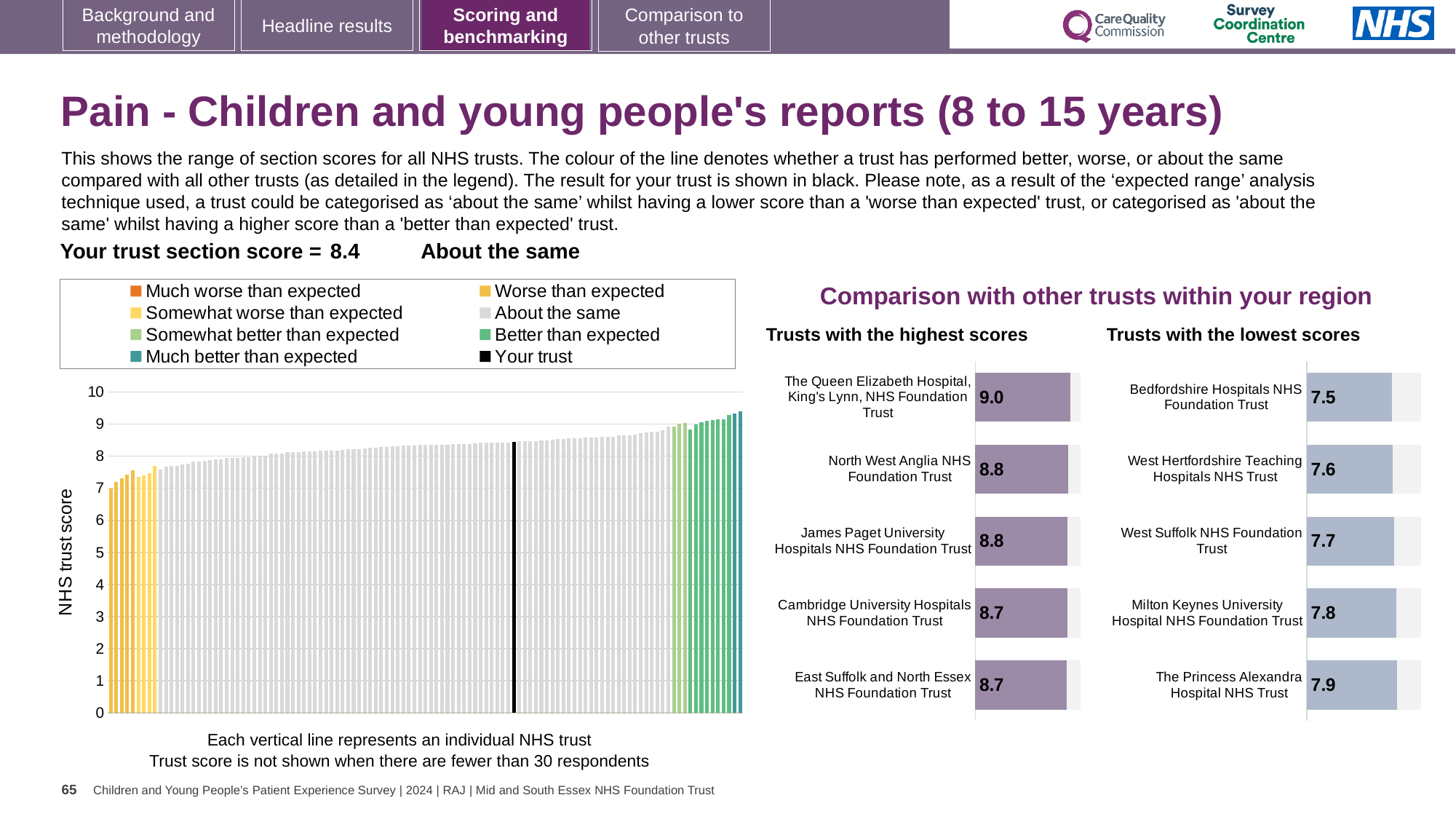
In the 'Trusts with the highest scores' chart, what is the score for The Queen Elizabeth Hospital, King's Lynn, NHS Foundation Trust? 9.0 How many entries does the legend of the large chart on the left list? 8 In the 'Trusts with the lowest scores' chart, which trust has the lowest score? Bedfordshire Hospitals NHS Foundation Trust In the 'Trusts with the lowest scores' chart, what is the score for Bedfordshire Hospitals NHS Foundation Trust? 7.5 In the 'Trusts with the highest scores' chart, which trust has the highest score? The Queen Elizabeth Hospital, King's Lynn, NHS Foundation Trust In the 'Trusts with the lowest scores' chart, which has the larger score: West Suffolk NHS Foundation Trust or Milton Keynes University Hospital NHS Foundation Trust? Milton Keynes University Hospital NHS Foundation Trust In the large chart on the left, do the trust scores rise or fall from left to right? Rise In the 'Trusts with the lowest scores' chart, what is the score for West Hertfordshire Teaching Hospitals NHS Trust? 7.6 What type of chart is the large chart on the left showing NHS trust scores? Bar chart In the 'Trusts with the lowest scores' chart, what is the difference between the score for The Princess Alexandra Hospital NHS Trust and the score for Bedfordshire Hospitals NHS Foundation Trust? 0.4 In the 'Trusts with the highest scores' chart, what is the difference between the score for The Queen Elizabeth Hospital, King's Lynn and the score for East Suffolk and North Essex NHS Foundation Trust? 0.3 How many trusts are listed in the 'Trusts with the highest scores' chart? 5